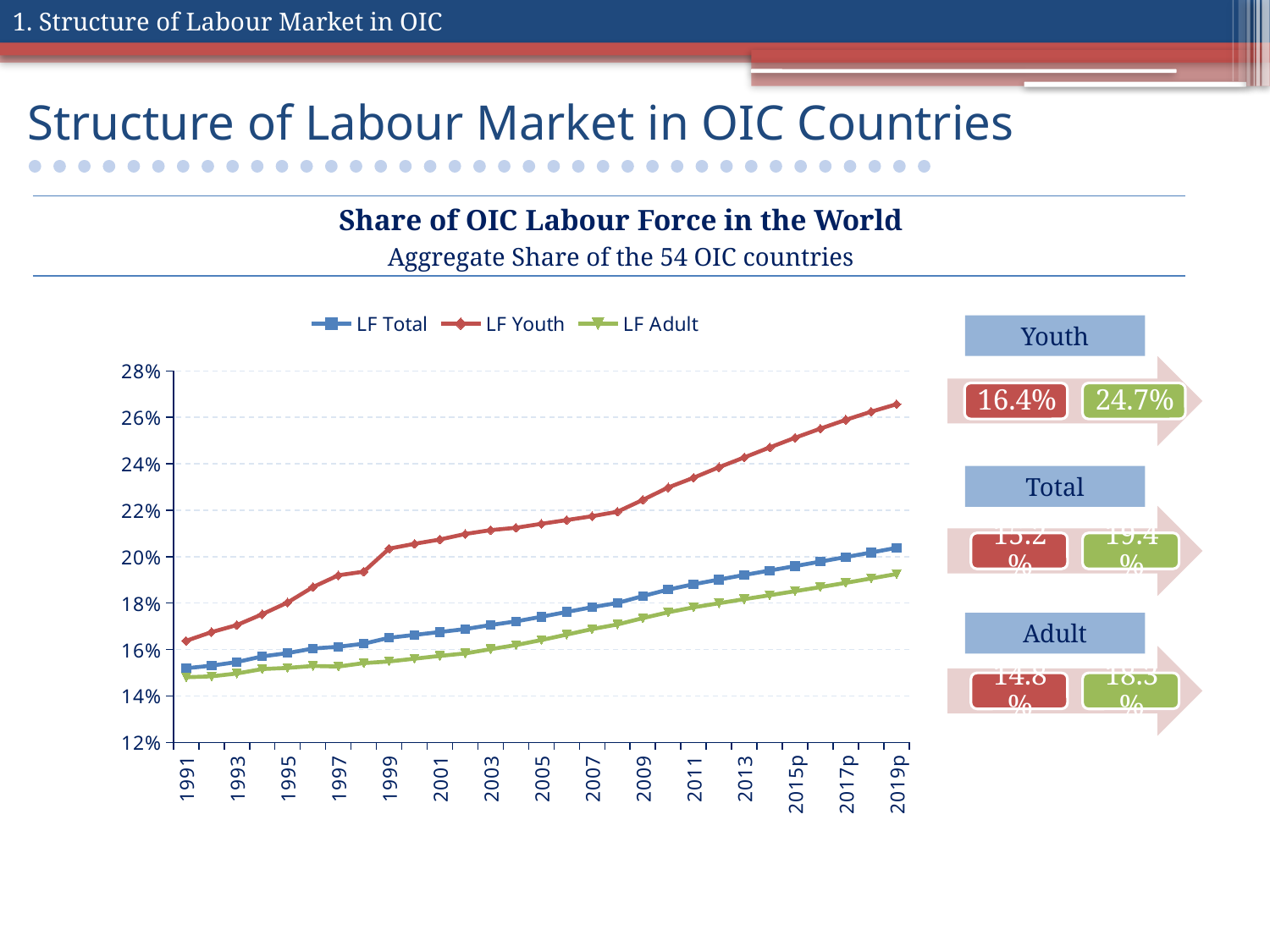
Is the value for LF Youth in 1991 greater or less than 18%? less What kind of chart is shown on the slide? Line chart Is the value for LF Total in 1991 greater or less than 16%? less Which series has the lowest value in 2019p? LF Adult What is the title of the chart? Share of OIC Labour Force in the World Which series has the highest value in 2019p? LF Youth Is the value for LF Adult in 2019p greater or less than 18%? greater In 2005, which is larger: LF Total or LF Adult? LF Total Do the values of LF Youth rise or fall from 1991 to 2019p? Rise How many year labels are shown on the x axis of the chart? 15 How many series does the chart legend list? 3